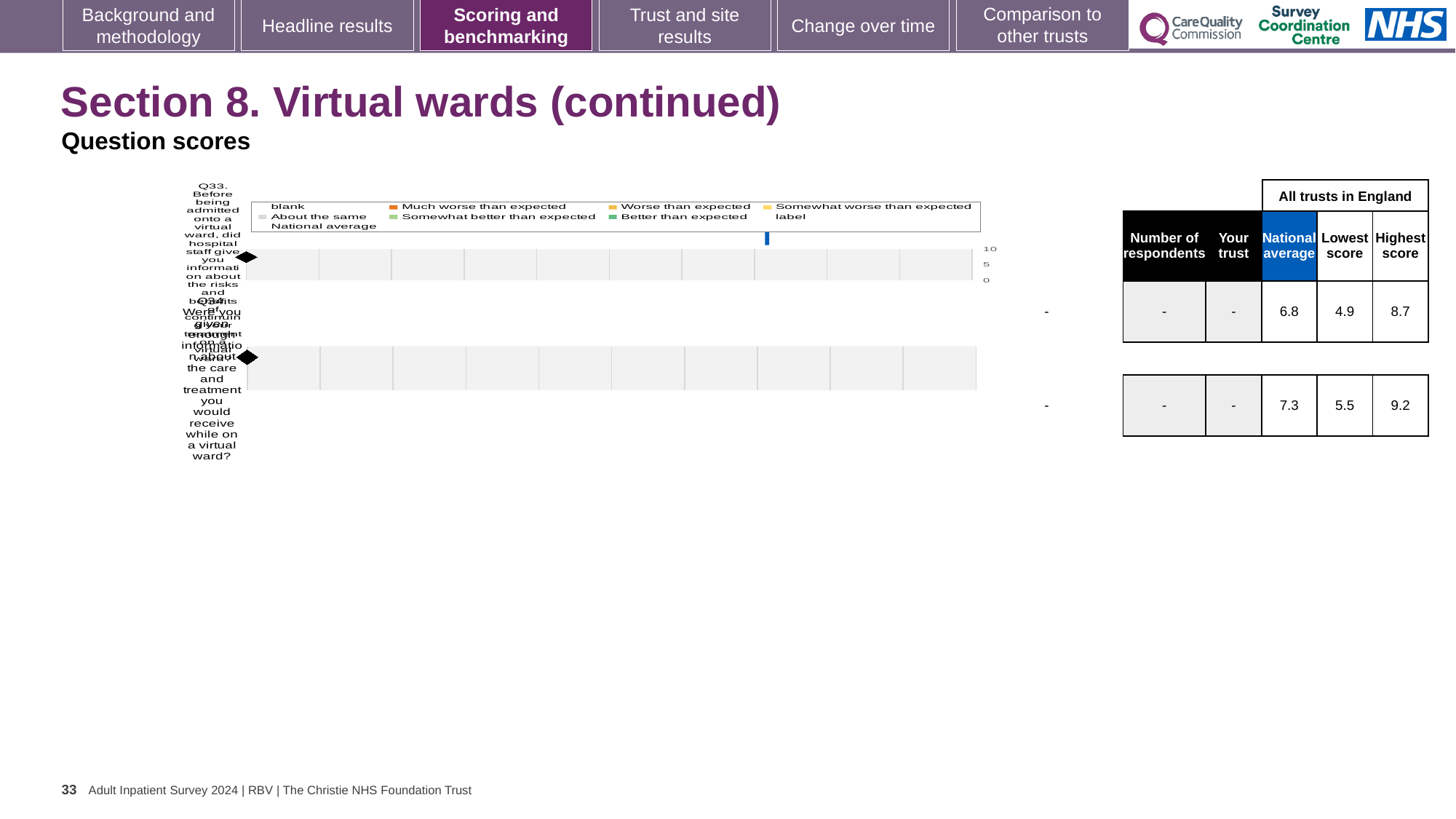
What is the highest value shown on the chart's horizontal axis? 10 What kind of chart is shown on the slide? bar chart Which legend entry is shown with an orange marker? Much worse than expected What is the difference between the highest score and the lowest score for Q33 in the table? 3.8 Which question has the higher national average in the table, Q33 or Q34? Q34 In the table next to the chart, what is the national average score for Q33? 6.8 In the table next to the chart, what is the lowest score among all trusts in England for Q33? 4.9 Is the national average for Q34 greater or less than 5? greater What value is shown for 'Your trust' for Q33 in the table? - In the table next to the chart, what is the highest score among all trusts in England for Q34? 9.2 How many questions (categories) are plotted on the chart? 2 In the table next to the chart, what is the national average score for Q34? 7.3